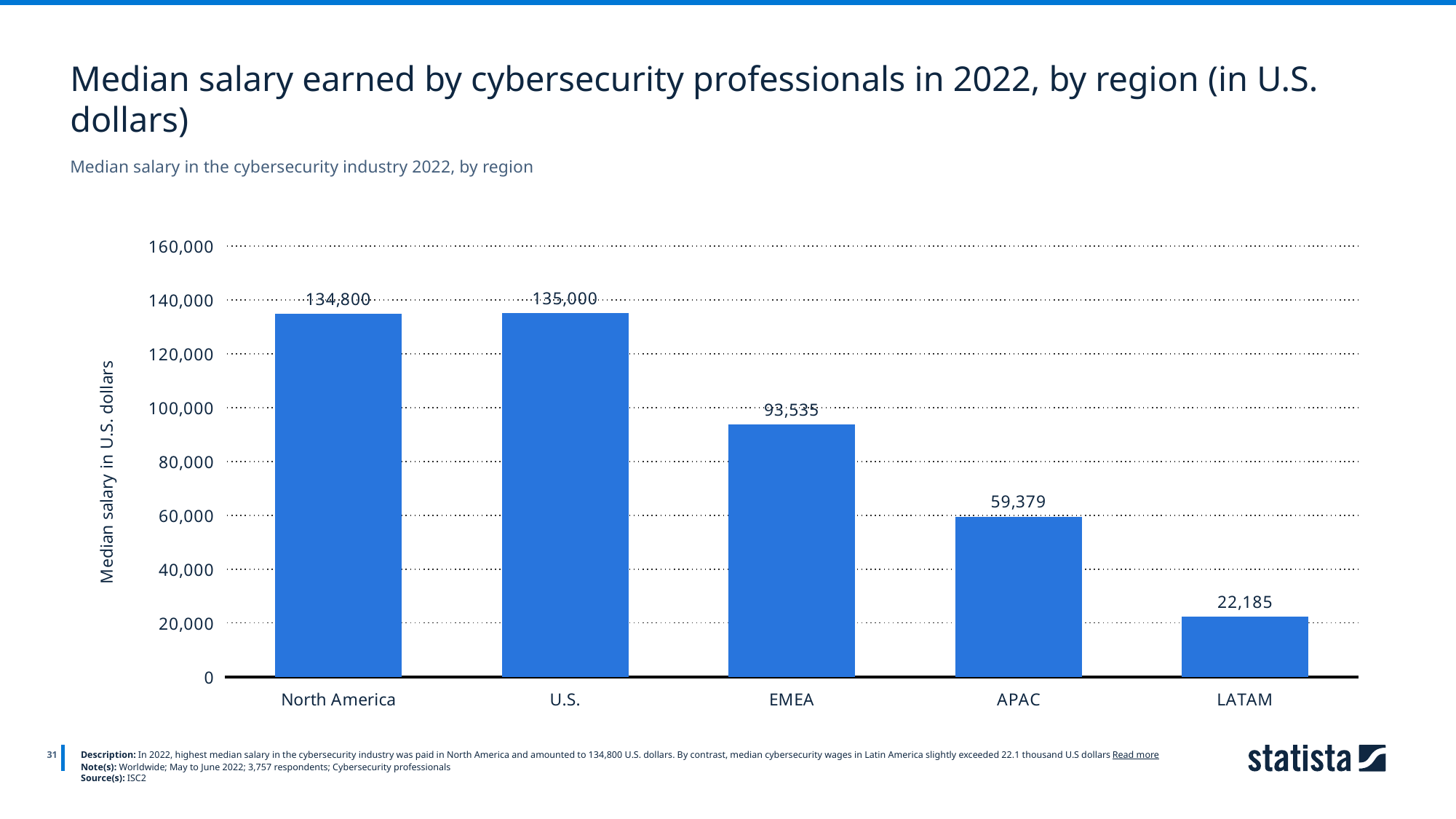
Is the value for EMEA greater or less than 100,000? less What is the median salary for North America? 134,800 What kind of chart is shown on the slide? bar chart Which has a higher median salary, EMEA or APAC? EMEA What is the difference between the median salaries of EMEA and APAC? 34,156 How many regions are shown in the chart? 5 What is the median salary for LATAM? 22,185 What is the median salary for APAC? 59,379 What is the median salary for EMEA? 93,535 What is the title of the vertical axis? Median salary in U.S. dollars Which region has the lowest median salary? LATAM What is the difference between the median salaries of North America and LATAM? 112,615